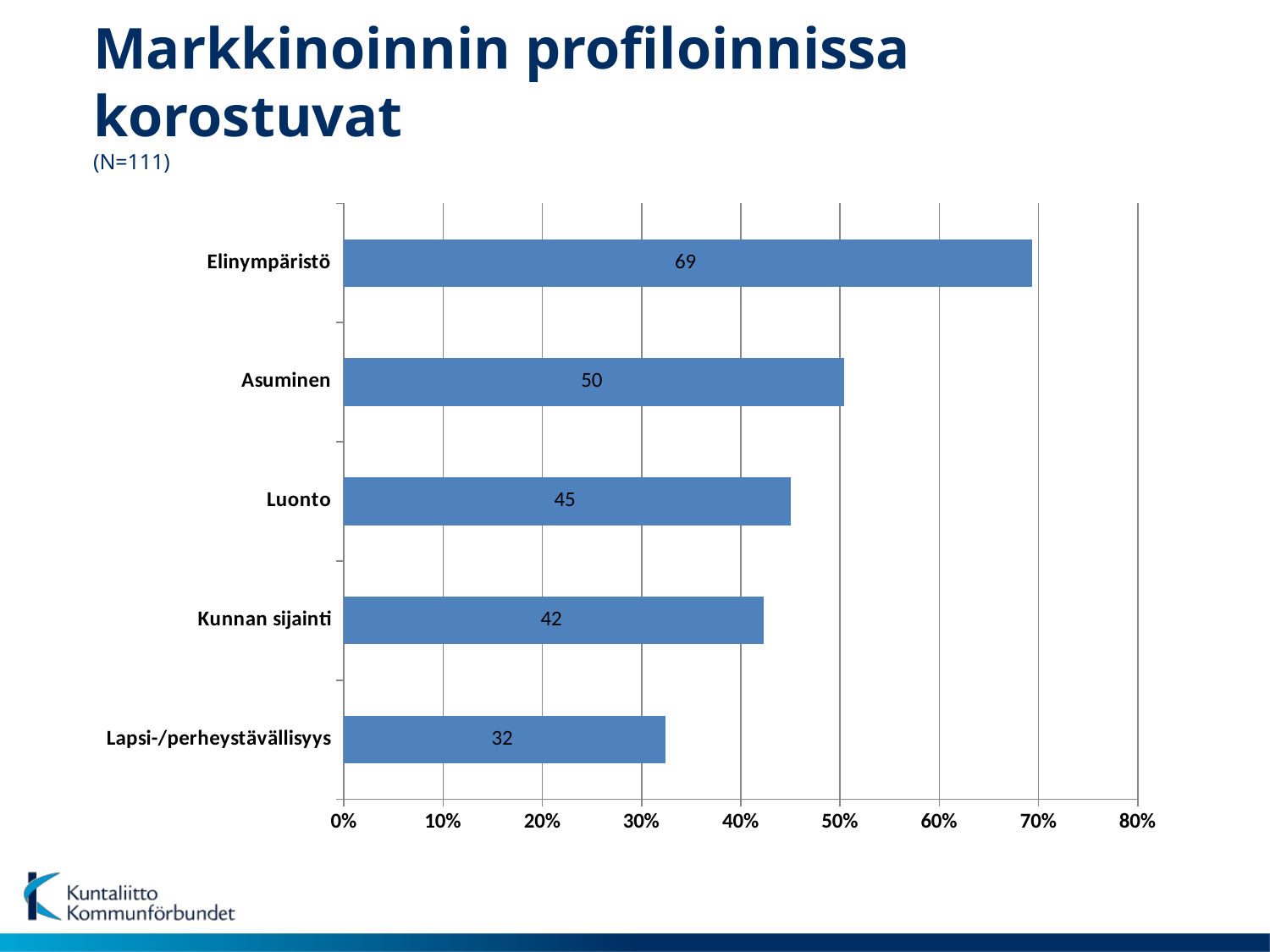
What kind of chart is shown on the slide? Bar chart What is the value shown for Asuminen? 50 What is the sample size (N) stated on the slide? N=111 What is the value shown for Luonto? 45 Which category has the highest value? Elinympäristö How many categories are shown in the chart? 5 What is the value shown for Lapsi-/perheystävällisyys? 32 What is the difference between the values for Elinympäristö and Asuminen? 19 Which category has the lowest value? Lapsi-/perheystävällisyys What is the value shown for Elinympäristö? 69 What is the value shown for Kunnan sijainti? 42 Which is larger, the value for Luonto or the value for Kunnan sijainti? Luonto